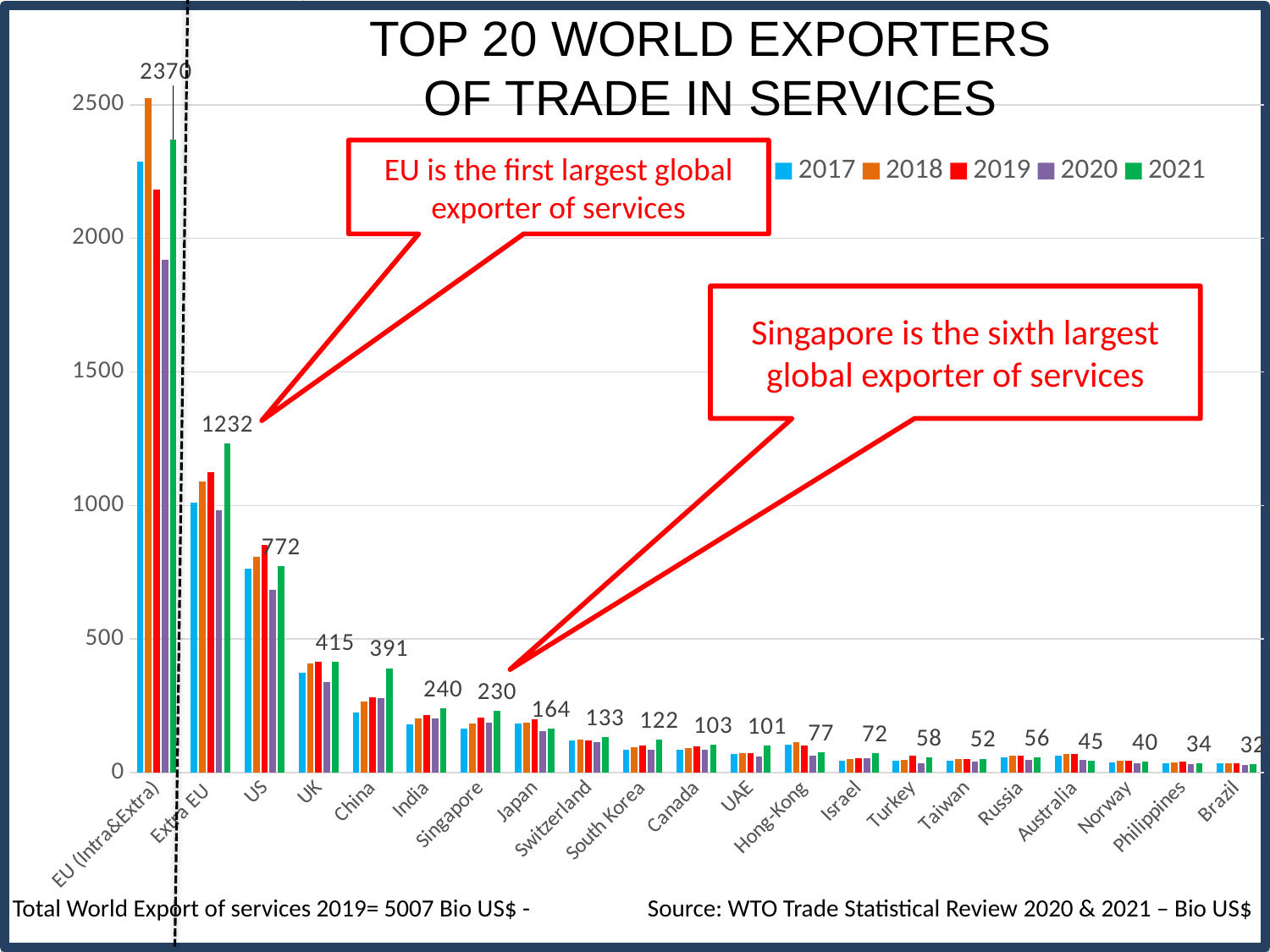
What is the 2021 value labelled for Brazil? 32 What is the title of the chart? TOP 20 WORLD EXPORTERS OF TRADE IN SERVICES What is the difference between the 2021 values labelled for the UK and China? 24 Is the 2018 value for EU (Intra&Extra) greater or less than 2500? greater How many series does the legend list? 5 Which category has the lowest 2021 value? Brazil Which category has the highest 2021 value? EU (Intra&Extra) What is the 2021 value labelled for Singapore? 230 Which has a larger 2021 value, India or Japan? India What is the 2021 value labelled for the US? 772 What type of chart is shown on the slide? bar chart